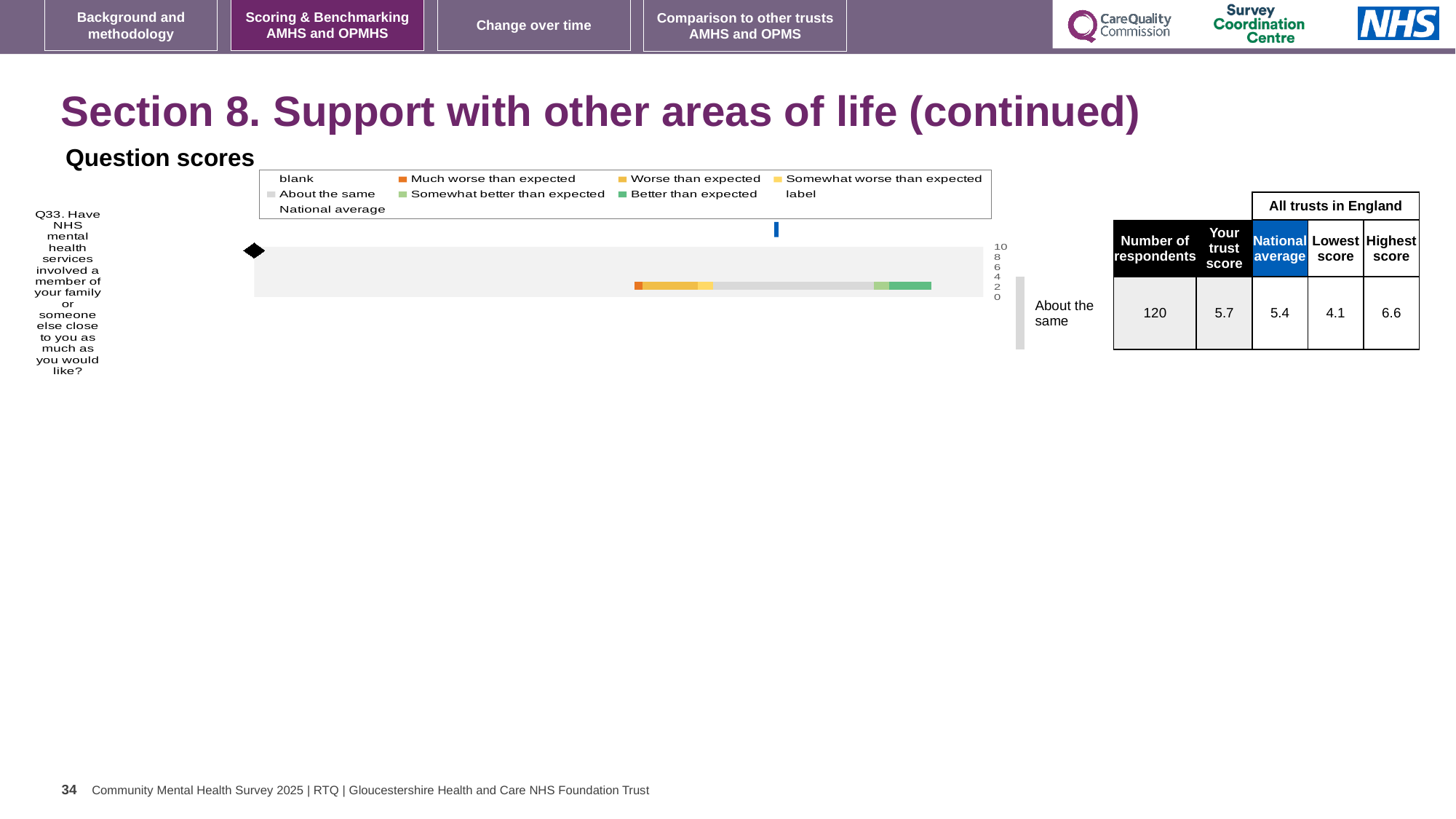
What is the difference between the highest and lowest scores for Q33 across all trusts in England? 2.5 In the Question scores chart, which legend entry is shown in orange? Much worse than expected What benchmark category is the trust's Q33 score placed in? About the same How many survey questions are plotted in the Question scores chart? 1 Which question is plotted in the Question scores chart? Q33. Have NHS mental health services involved a member of your family or someone else close to you as much as you would like? How many respondents answered Q33? 120 Which is larger for Q33, the trust score or the national average? trust score What is the lowest score among all trusts in England for Q33? 4.1 What is the trust's score for Q33 as shown next to the chart? 5.7 What is the highest score among all trusts in England for Q33? 6.6 What is the national average score for Q33? 5.4 What kind of chart is shown under 'Question scores'? bar chart